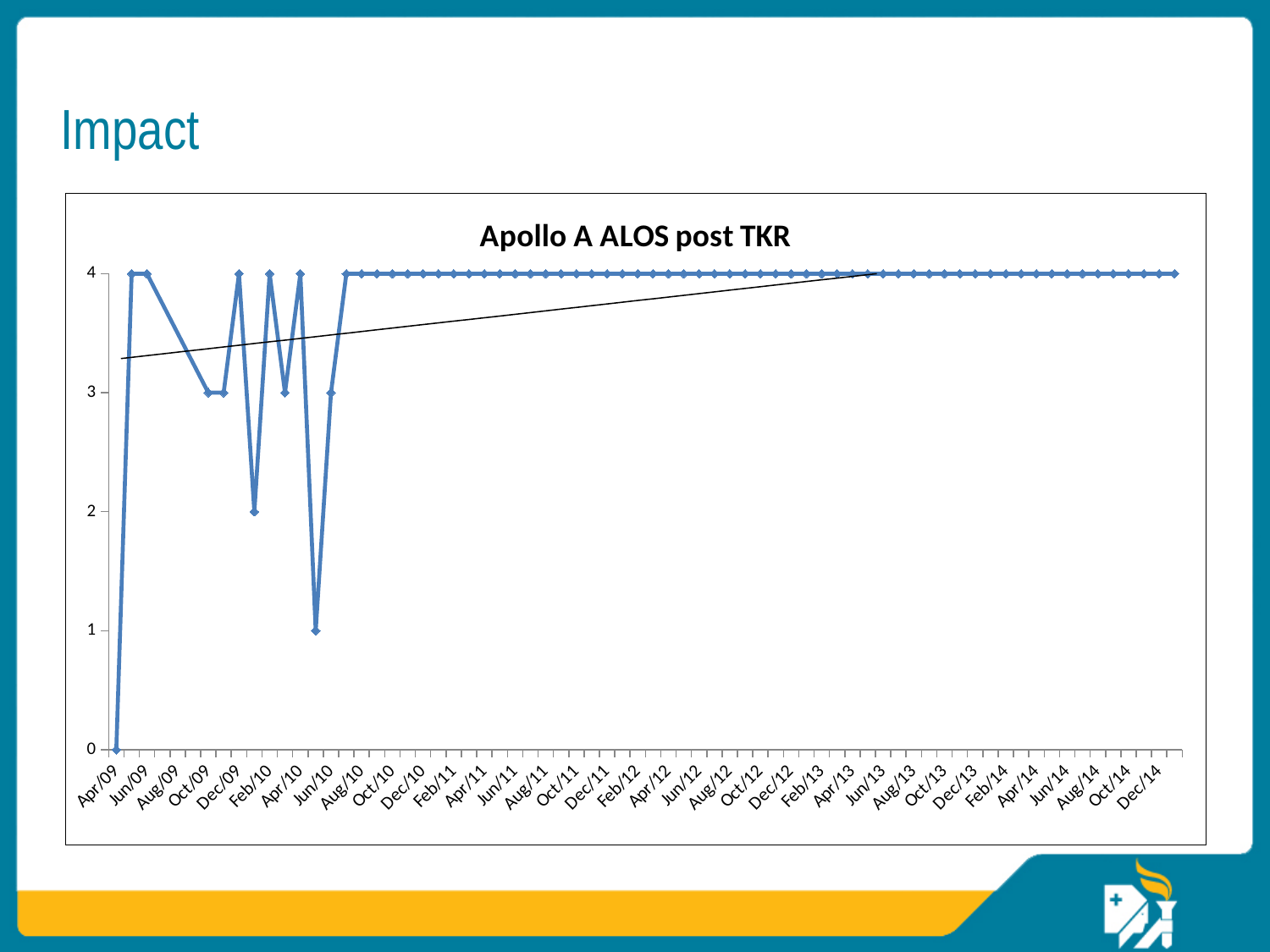
What is the value for Jun/10? 3 Do the values generally rise or fall from Apr/09 to Dec/14? rise What type of chart is shown on the slide? line chart What is the highest value reached on the chart? 4 What is the value for Dec/14? 4 What is the title of the chart? Apollo A ALOS post TKR Which month has the lowest value? Apr/09 What is the value for Apr/09? 0